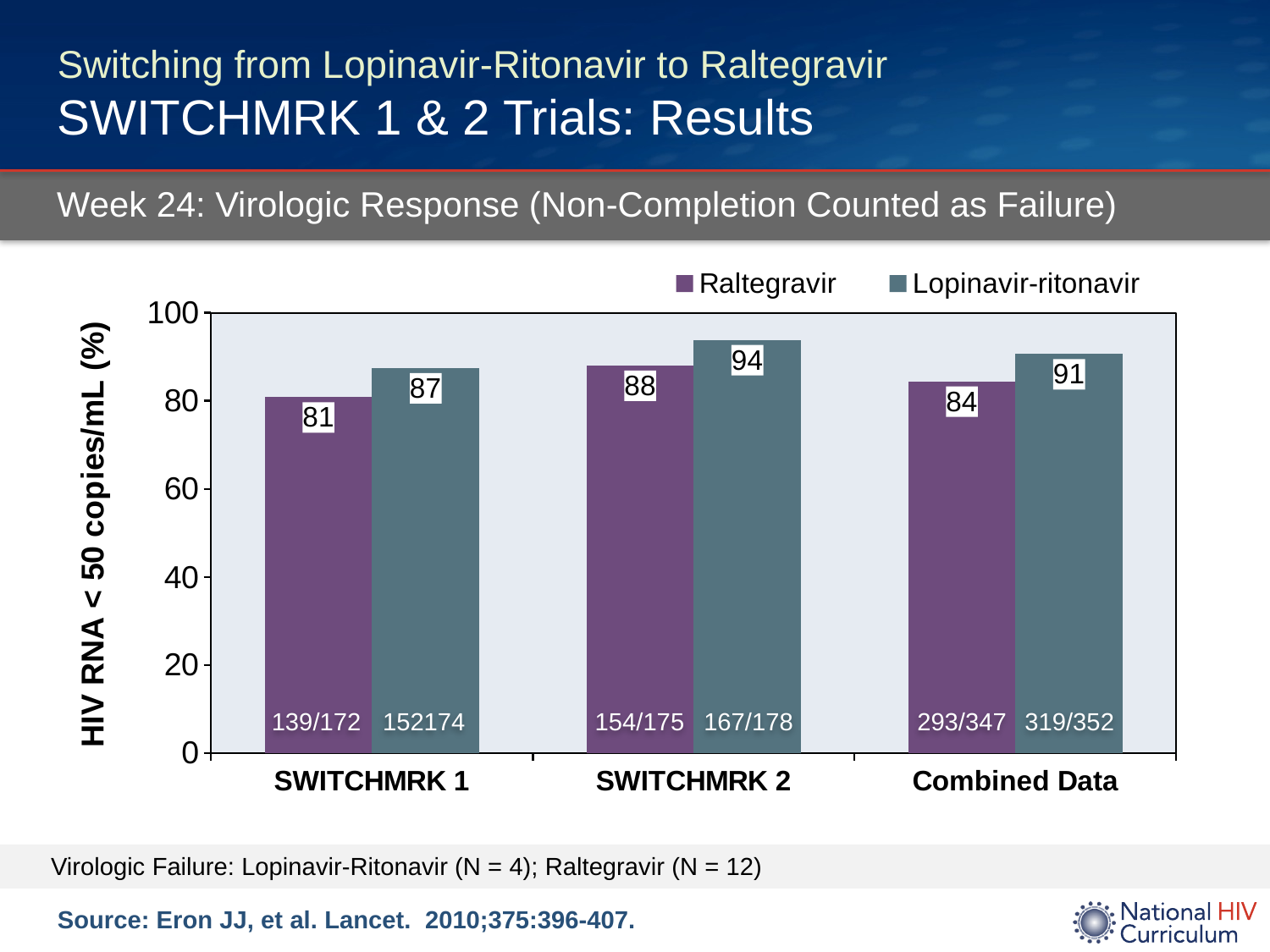
How many series does the legend list? 2 Which group has the lowest Raltegravir value? SWITCHMRK 1 What is the y-axis label of the chart? HIV RNA < 50 copies/mL (%) What kind of chart is shown on the slide? Bar chart What is the value for Raltegravir in SWITCHMRK 1? 81 How many groups are shown on the x axis? 3 What is the value for Lopinavir-ritonavir in SWITCHMRK 2? 94 Which group has the highest Lopinavir-ritonavir value? SWITCHMRK 2 What is the difference between the Lopinavir-ritonavir and Raltegravir values in SWITCHMRK 2? 6 What is the value for Lopinavir-ritonavir in SWITCHMRK 1? 87 In the Combined Data group, which series has the larger value, Raltegravir or Lopinavir-ritonavir? Lopinavir-ritonavir What is the value for Raltegravir in the Combined Data group? 84